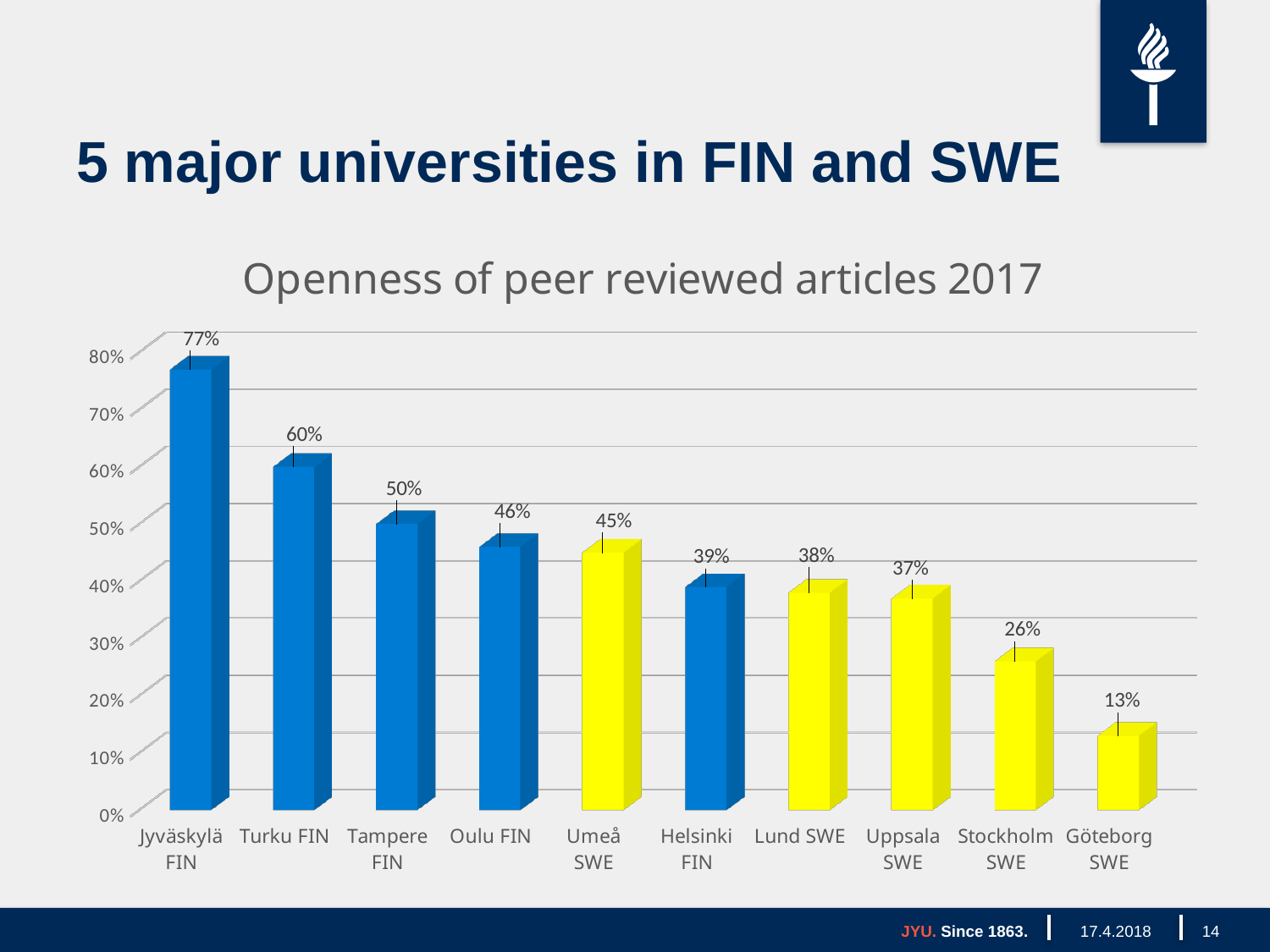
Which has a higher value, Umeå SWE or Helsinki FIN? Umeå SWE What is the value for Göteborg SWE? 13% Do the values rise or fall from left to right along the x axis? fall What is the value for Uppsala SWE? 37% Is the value for Stockholm SWE greater or less than 30%? less What kind of chart is shown on the slide? bar chart What is the value for Jyväskylä FIN? 77% How many universities are shown in the chart? 10 Which university has the lowest openness of peer reviewed articles? Göteborg SWE What is the title of the chart? Openness of peer reviewed articles 2017 What is the difference between the values for Turku FIN and Oulu FIN? 14% Which university has the highest openness of peer reviewed articles? Jyväskylä FIN